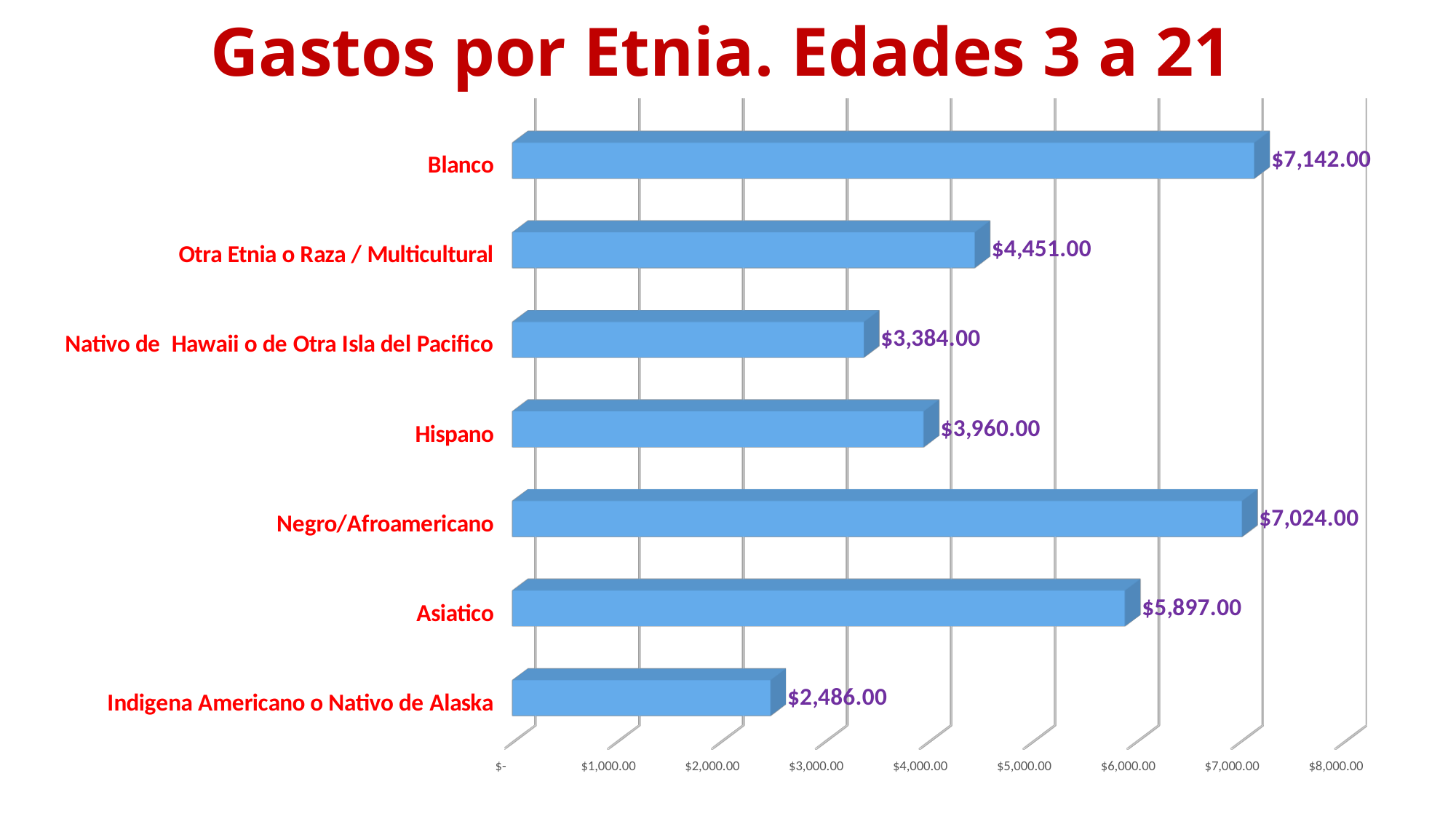
Which category has the highest value? Blanco What kind of chart is shown on the slide? Bar chart What is the value for Blanco? $7,142.00 How many categories are shown in the chart? 7 What is the difference between the values for Blanco and Negro/Afroamericano? $118.00 Which category has the lowest value? Indigena Americano o Nativo de Alaska What is the value for Hispano? $3,960.00 What is the value for Asiatico? $5,897.00 What is the value for Indigena Americano o Nativo de Alaska? $2,486.00 Is the value for Asiatico greater or less than $5,000.00? greater What is the difference between the values for Hispano and Nativo de Hawaii o de Otra Isla del Pacifico? $576.00 Which is larger, the value for Otra Etnia o Raza / Multicultural or the value for Hispano? Otra Etnia o Raza / Multicultural